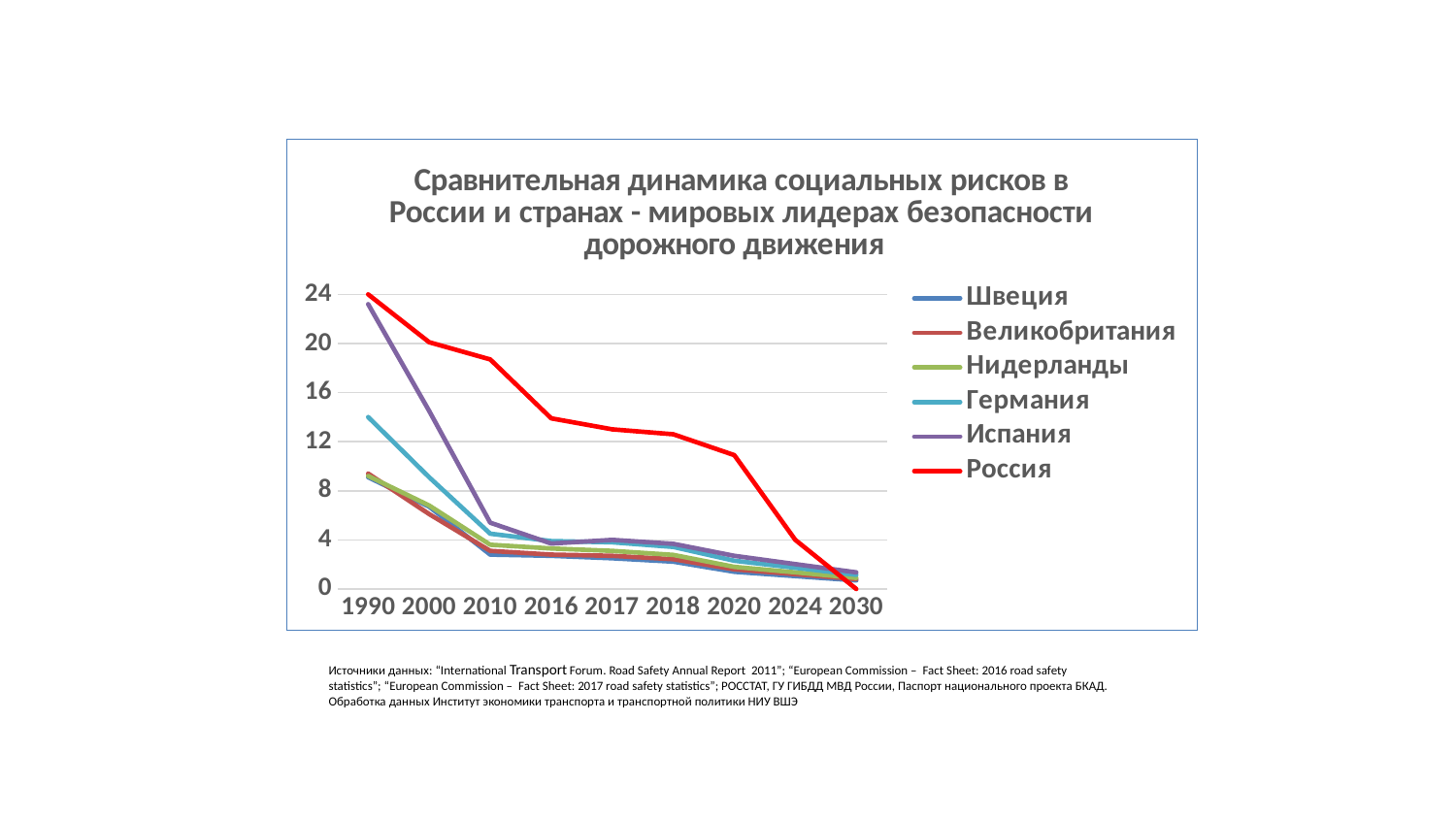
Is the value for Россия in 2020 greater or less than 12? less Which is larger in 2010, the value for Россия or the value for Швеция? Россия What kind of chart is shown on the slide? line chart Is the value for Россия in 2010 greater or less than 20? less Does the value for Россия rise or fall from 1990 to 2030? fall What colour is the line for Россия? red Which series has the highest value in 1990? Россия How many series does the legend list? 6 Is the value for Испания in 1990 greater or less than 20? greater Which series has the highest value in 2020? Россия How many years are shown along the x axis? 9